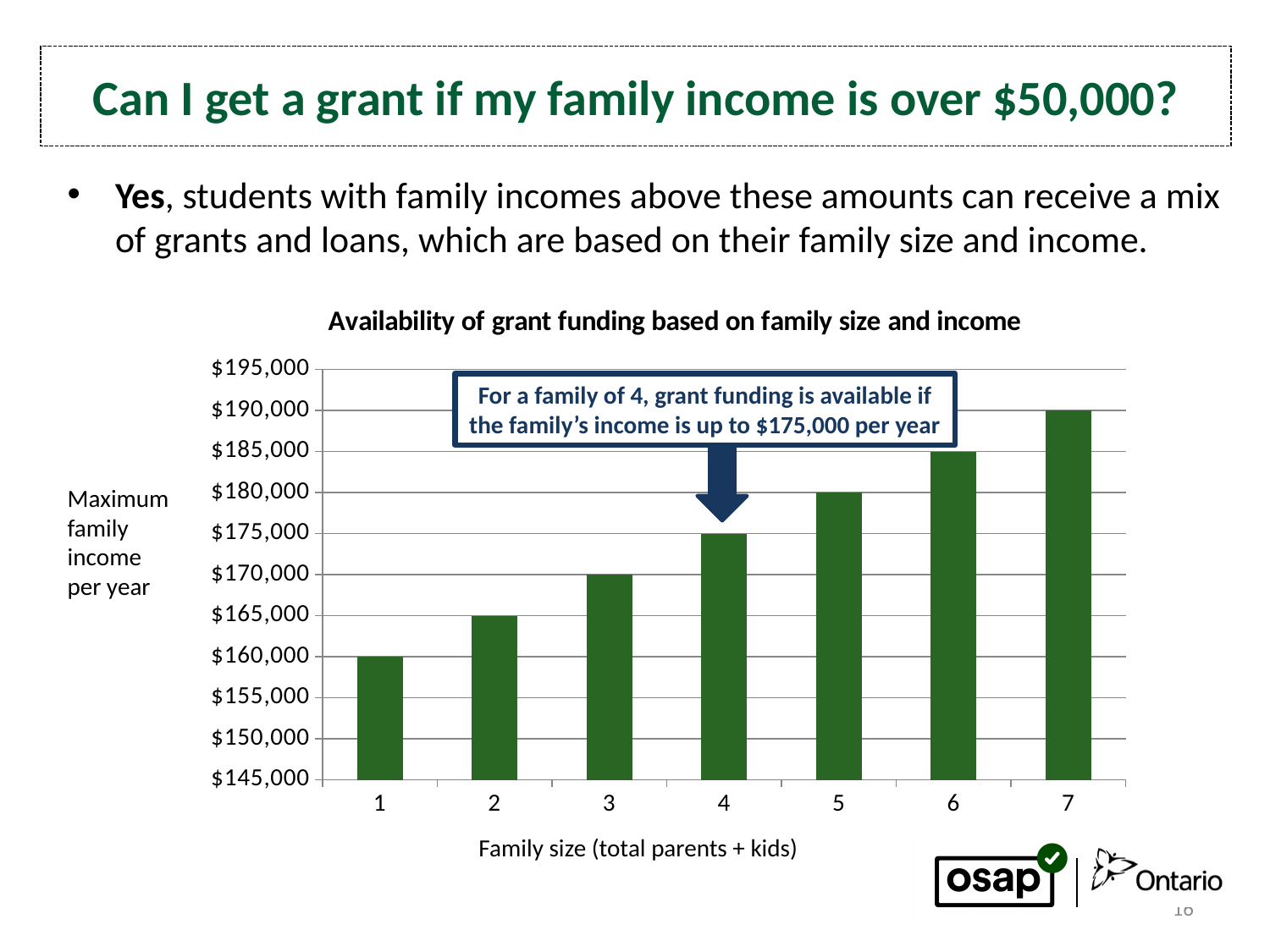
Do the values rise or fall as family size increases along the x axis? rise Which family size has the highest maximum family income per year? 7 Which has a higher maximum family income per year, a family size of 3 or a family size of 5? 5 What is the maximum family income per year for a family size of 7? $190,000 Which family size has the lowest maximum family income per year? 1 What is the difference in maximum family income between a family size of 6 and a family size of 2? $20,000 What is the maximum family income per year for a family size of 4? $175,000 What is the maximum family income per year for a family size of 1? $160,000 How many family-size categories are plotted on the chart? 7 What kind of chart is shown on the slide? bar chart What is the label of the x axis? Family size (total parents + kids) What is the title of the chart? Availability of grant funding based on family size and income